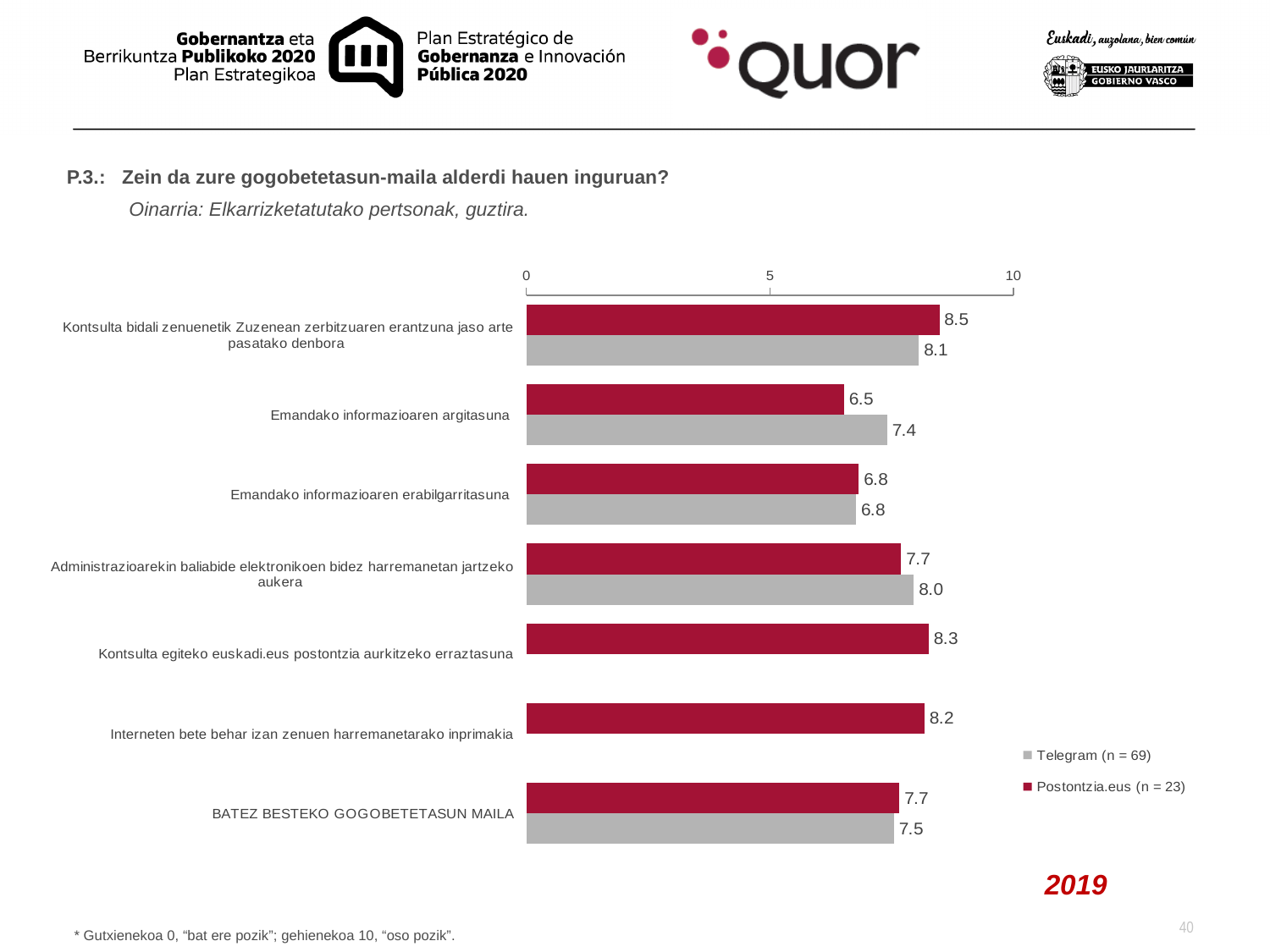
Which category has the highest Postontzia.eus value? Kontsulta bidali zenuenetik Zuzenean zerbitzuaren erantzuna jaso arte pasatako denbora What sample size does the legend give for Telegram? n = 69 What is the Telegram value for 'BATEZ BESTEKO GOGOBETETASUN MAILA'? 7.5 What is the Postontzia.eus value for 'Kontsulta egiteko euskadi.eus postontzia aurkitzeko erraztasuna'? 8.3 Which category has the lowest Telegram value? Emandako informazioaren erabilgarritasuna What is the difference between the Postontzia.eus and Telegram values for 'Emandako informazioaren argitasuna'? 0.9 What is the Postontzia.eus value for 'Emandako informazioaren argitasuna'? 6.5 How many series does the legend list? 2 For 'Kontsulta bidali zenuenetik Zuzenean zerbitzuaren erantzuna jaso arte pasatako denbora', which series has the larger value, Telegram or Postontzia.eus? Postontzia.eus What is the Telegram value for 'Administrazioarekin baliabide elektronikoen bidez harremanetan jartzeko aukera'? 8.0 How many categories are shown on the chart? 7 What kind of chart is shown on the slide? bar chart